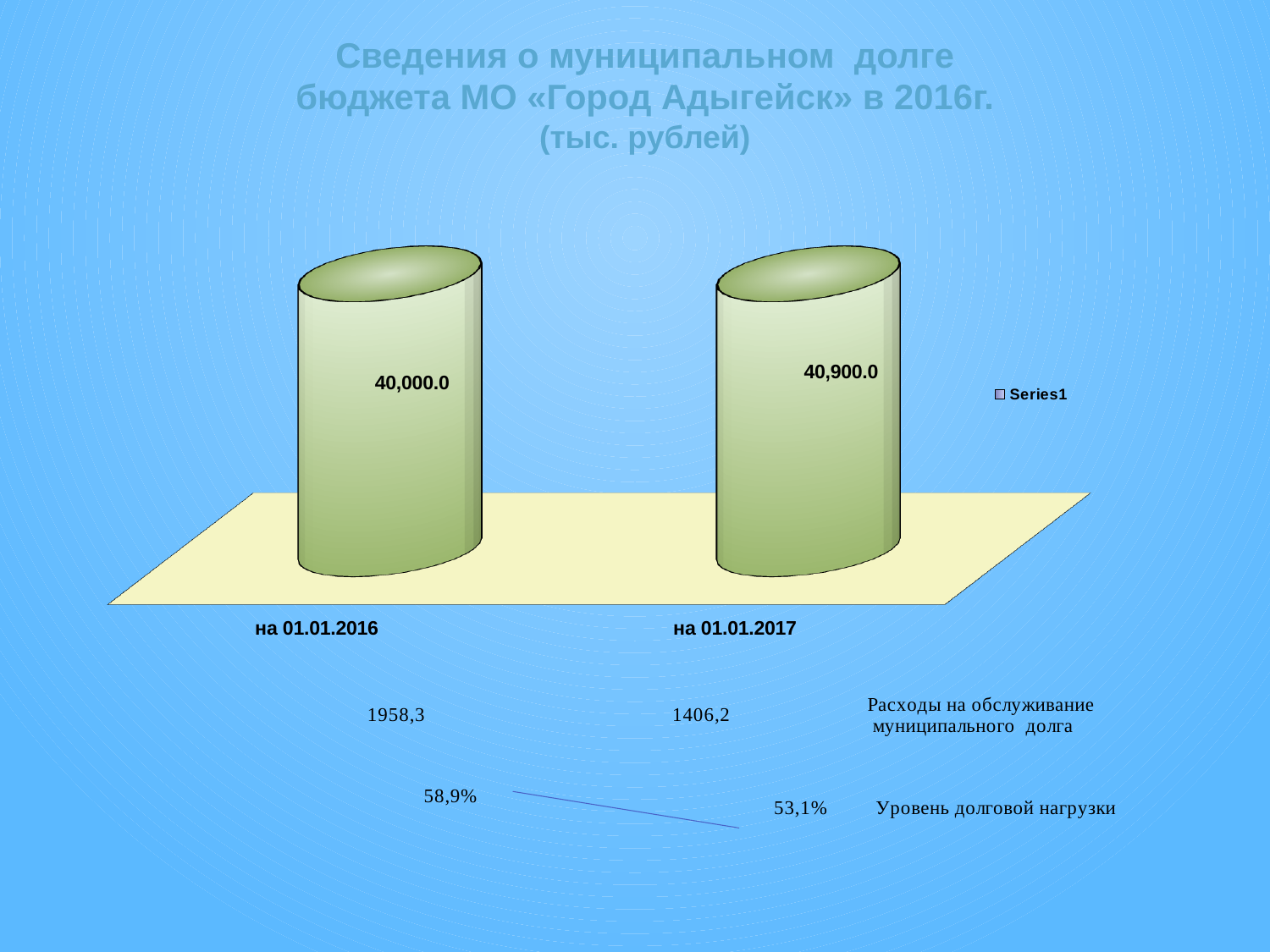
Do the values rise or fall from на 01.01.2016 to на 01.01.2017? rise How many series does the legend list? 1 What is the name of the series listed in the legend? Series1 What is the value shown for на 01.01.2017? 40,900.0 How many categories are plotted in the chart? 2 Which category has the highest value? на 01.01.2017 What is the difference between the values for на 01.01.2017 and на 01.01.2016? 900.0 What kind of chart is shown on the slide? bar chart In what units are the chart values given, according to the slide title? тыс. рублей What is the value shown for на 01.01.2016? 40,000.0 Which is larger, the value for на 01.01.2016 or the value for на 01.01.2017? на 01.01.2017 Which category has the lowest value? на 01.01.2016